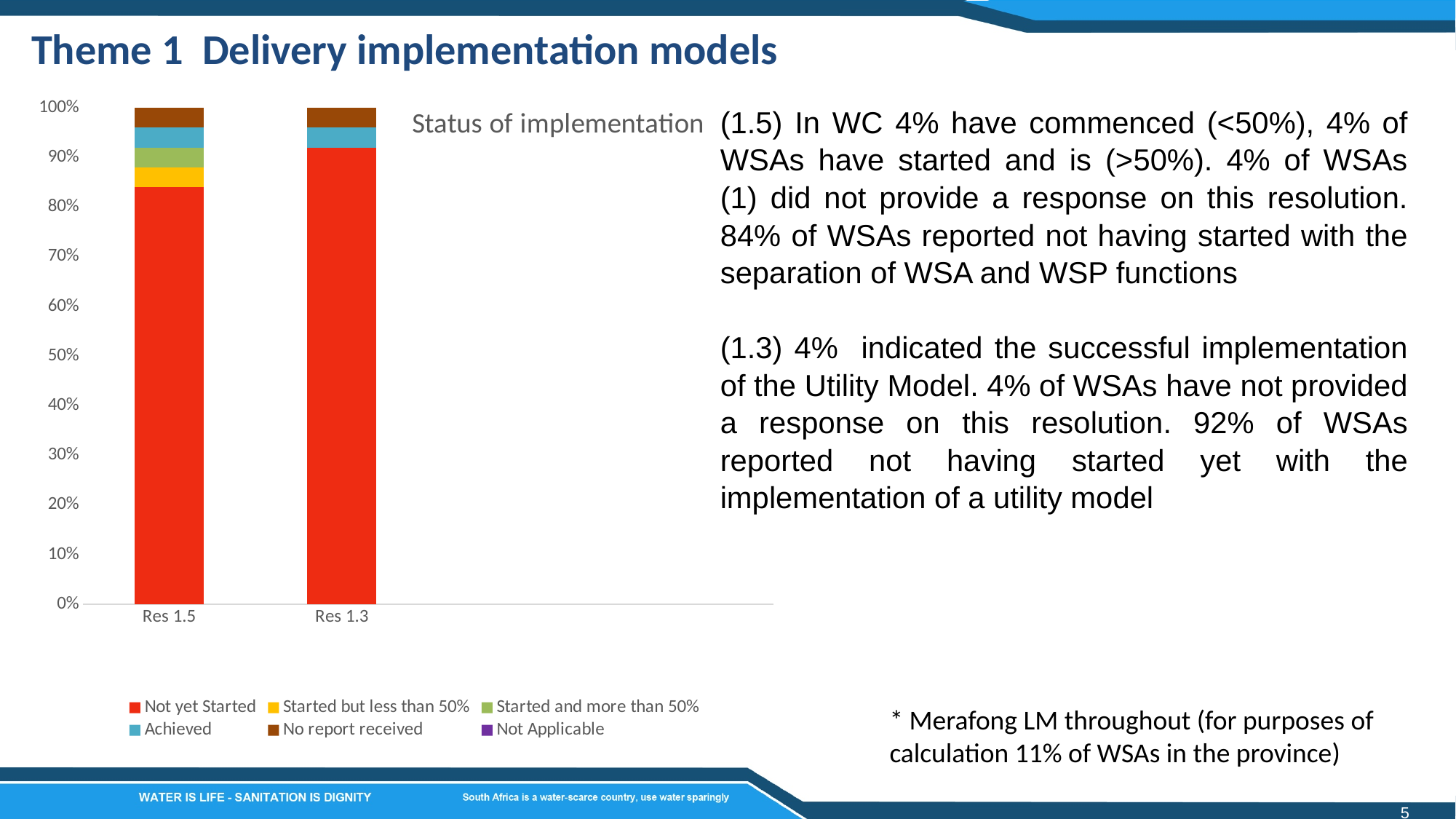
How many series does the chart legend list? 6 Which category has the larger 'Not yet Started' share, Res 1.5 or Res 1.3? Res 1.3 What is the title of the chart? Status of implementation Is the 'Not yet Started' value for Res 1.5 greater or less than 90%? less What is the total height of the stacked bar for Res 1.5? 100% What is the total height of the stacked bar for Res 1.3? 100% How many categories are shown on the x axis of the chart? 2 Which category's bar shows the 'Started but less than 50%' segment, Res 1.5 or Res 1.3? Res 1.5 Which colour represents the 'Not yet Started' series in the chart? red What kind of chart is shown on the slide? bar chart Is the 'Not yet Started' value for Res 1.3 greater or less than 90%? greater Is the 'Not yet Started' value for Res 1.5 greater or less than 80%? greater